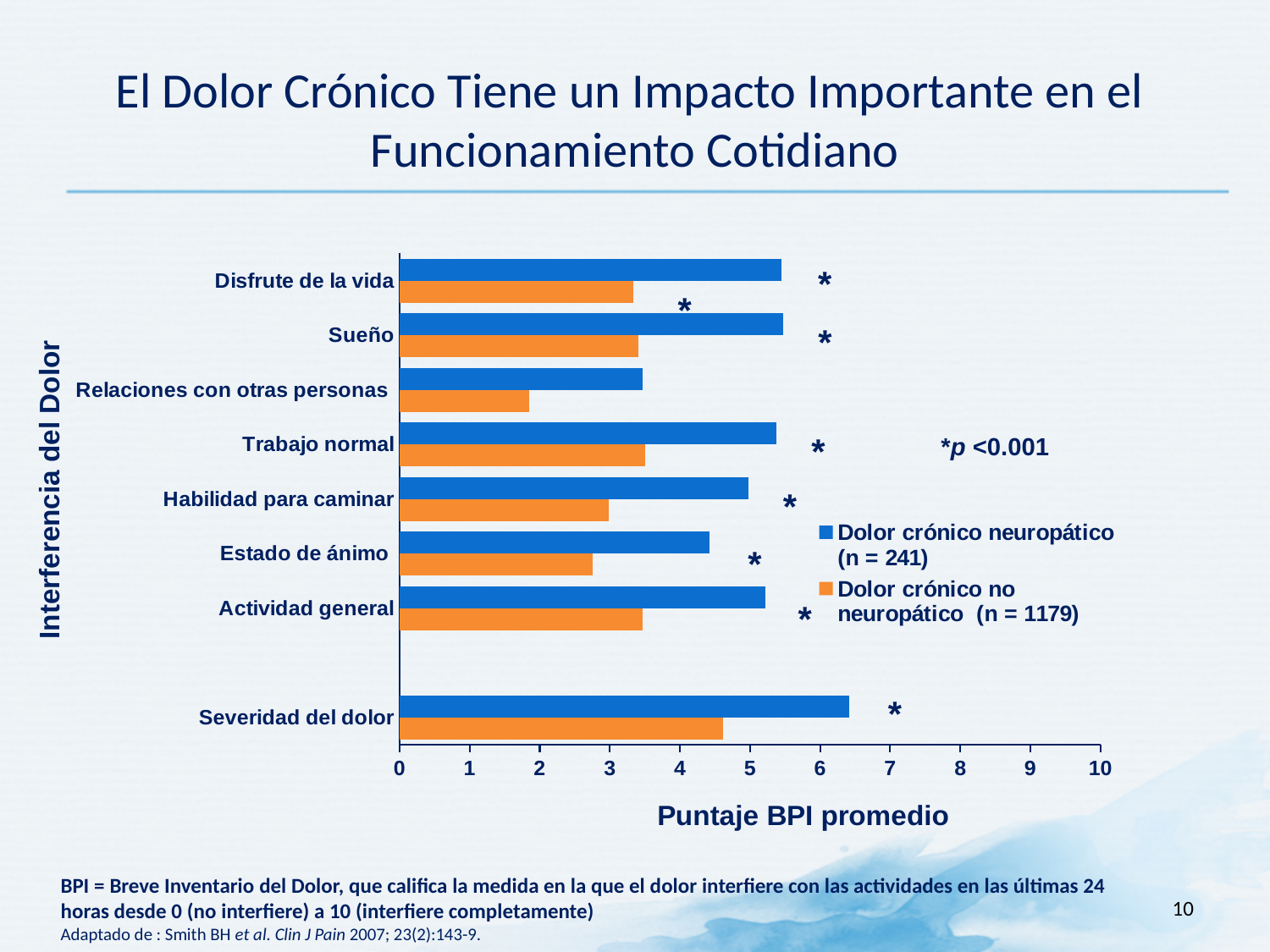
What is the title of the x axis? Puntaje BPI promedio How many series does the legend list? 2 Is the value for Estado de ánimo in the Dolor crónico neuropático series greater or less than 5? less Which category has the lowest value for Dolor crónico no neuropático (n = 1179)? Relaciones con otras personas Which colour represents Dolor crónico no neuropático (n = 1179) in the legend? orange How many categories are plotted on the y axis? 8 Is the value for Relaciones con otras personas in the Dolor crónico no neuropático series greater or less than 2? less For Sueño, which series has the larger value: Dolor crónico neuropático or Dolor crónico no neuropático? Dolor crónico neuropático Is the value for Severidad del dolor in the Dolor crónico neuropático series greater or less than 6? greater What kind of chart is shown on the slide? bar chart Which category has the highest value for Dolor crónico neuropático (n = 241)? Severidad del dolor Which category has the lowest value for Dolor crónico neuropático (n = 241)? Relaciones con otras personas